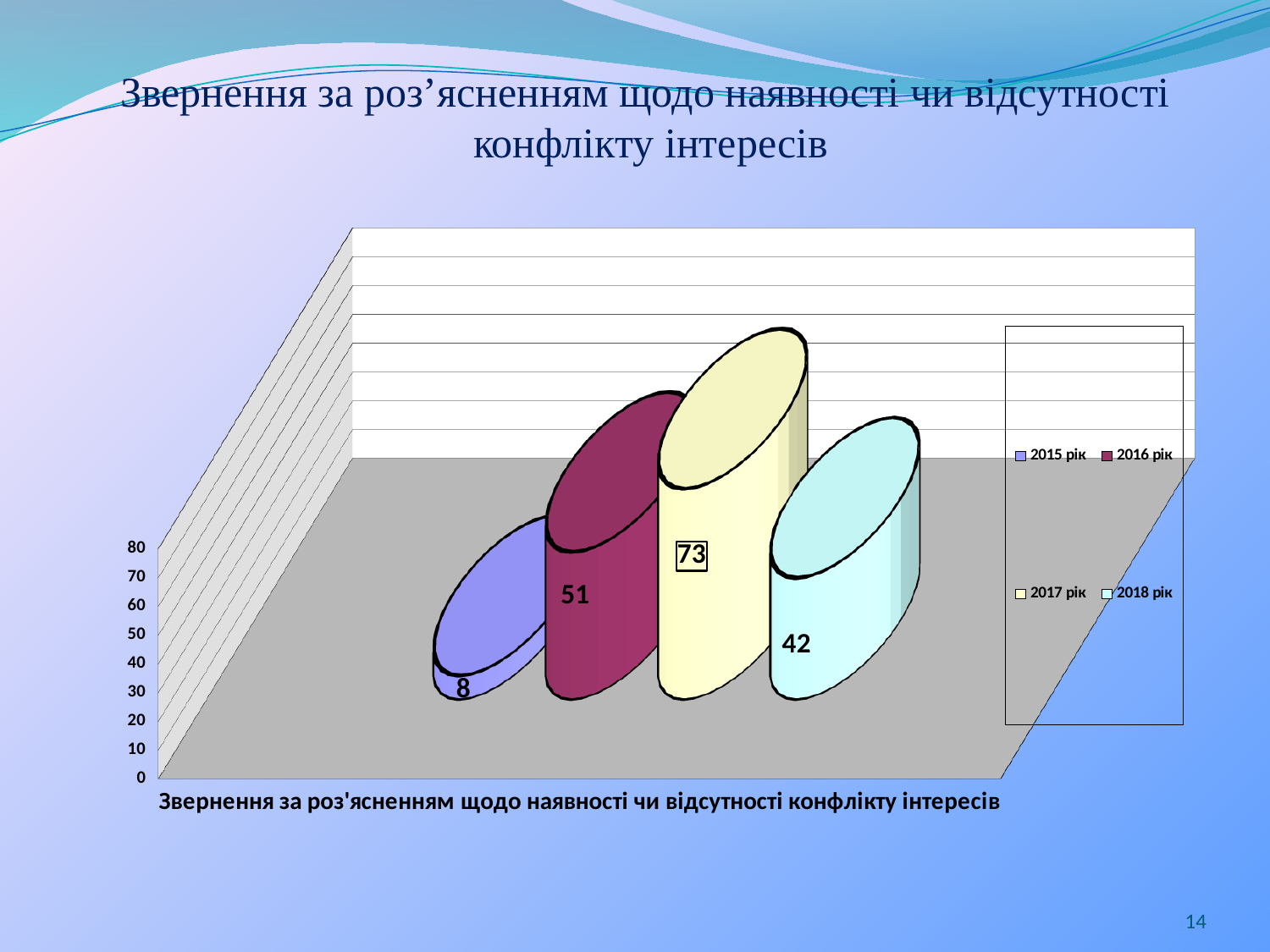
What is the value for 2015 рік? 8 What is the difference between the values for 2018 рік and 2015 рік? 34 What is the value for 2018 рік? 42 What kind of chart is shown on the slide? Bar chart What is the value for 2016 рік? 51 What is the difference between the values for 2017 рік and 2016 рік? 22 How many series does the legend list? 4 Which year has the lowest value? 2015 рік What is the label on the x axis of the chart? Звернення за роз'ясненням щодо наявності чи відсутності конфлікту інтересів Which year has the highest value? 2017 рік Which is larger, the value for 2016 рік or the value for 2018 рік? 2016 рік What is the value for 2017 рік? 73